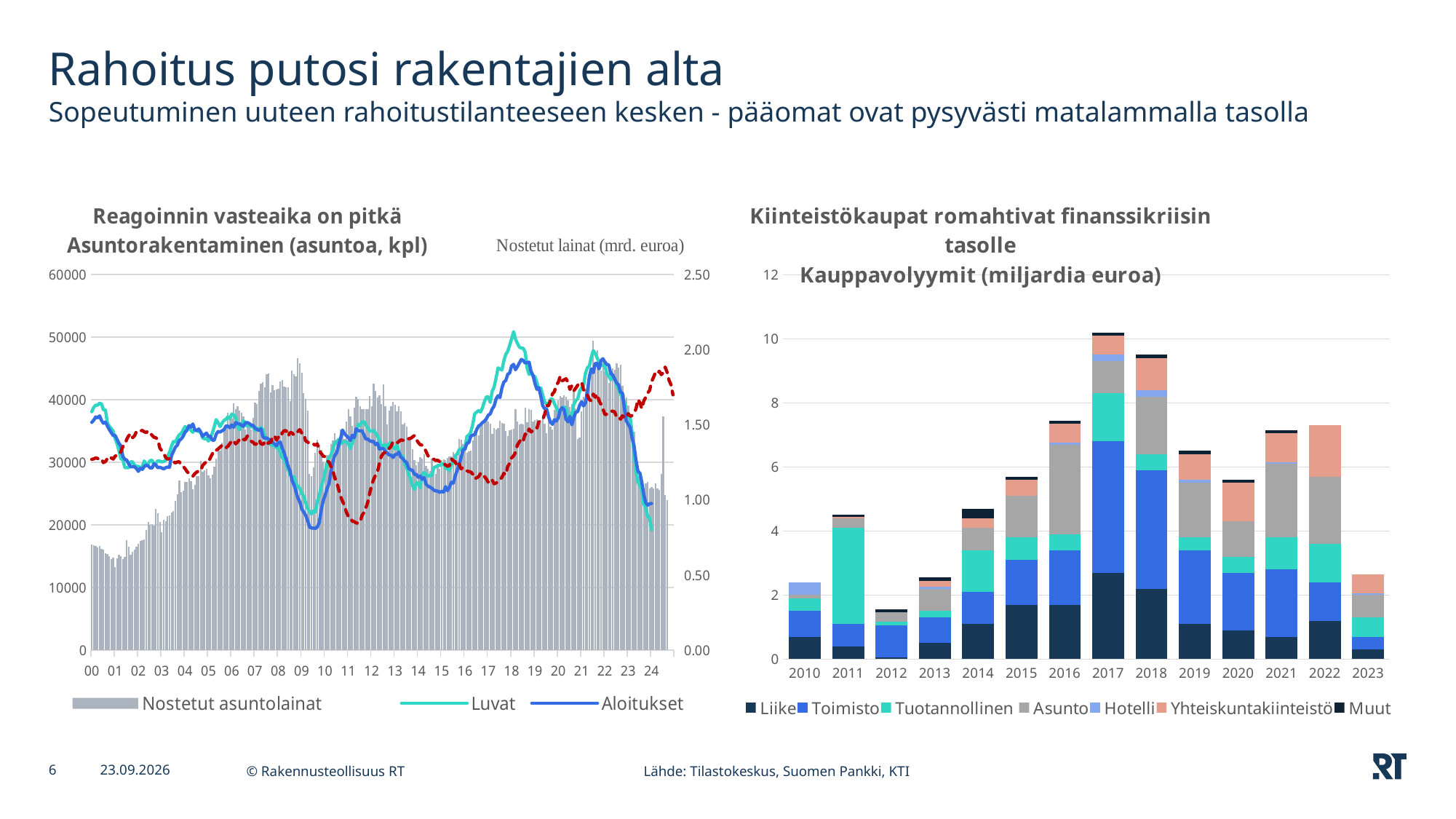
In the right chart (Kauppavolyymit), is the total for 2012 greater or less than 2? less How many series does the legend of the right chart (Kauppavolyymit) list? 7 In the right chart (Kauppavolyymit), is the total for 2023 greater or less than 4? less In the right chart (Kauppavolyymit), how many years are shown on the x axis? 14 In the right chart (Kauppavolyymit), is the total for 2017 greater or less than 8? greater In the right chart (Kauppavolyymit), which year has the highest total bar? 2017 How many series does the legend of the left chart (Asuntorakentaminen) list? 3 In the left chart (Asuntorakentaminen), which legend entry is shown as grey bars? Nostetut asuntolainat In the left chart (Asuntorakentaminen), what is the highest value shown on the left vertical axis? 60000 In the right chart (Kauppavolyymit), which year has the larger total bar, 2011 or 2012? 2011 In the right chart (Kauppavolyymit), which year has the lowest total bar? 2012 What kind of chart is the chart on the right, titled 'Kiinteistökaupat romahtivat finanssikriisin tasolle'? stacked bar chart